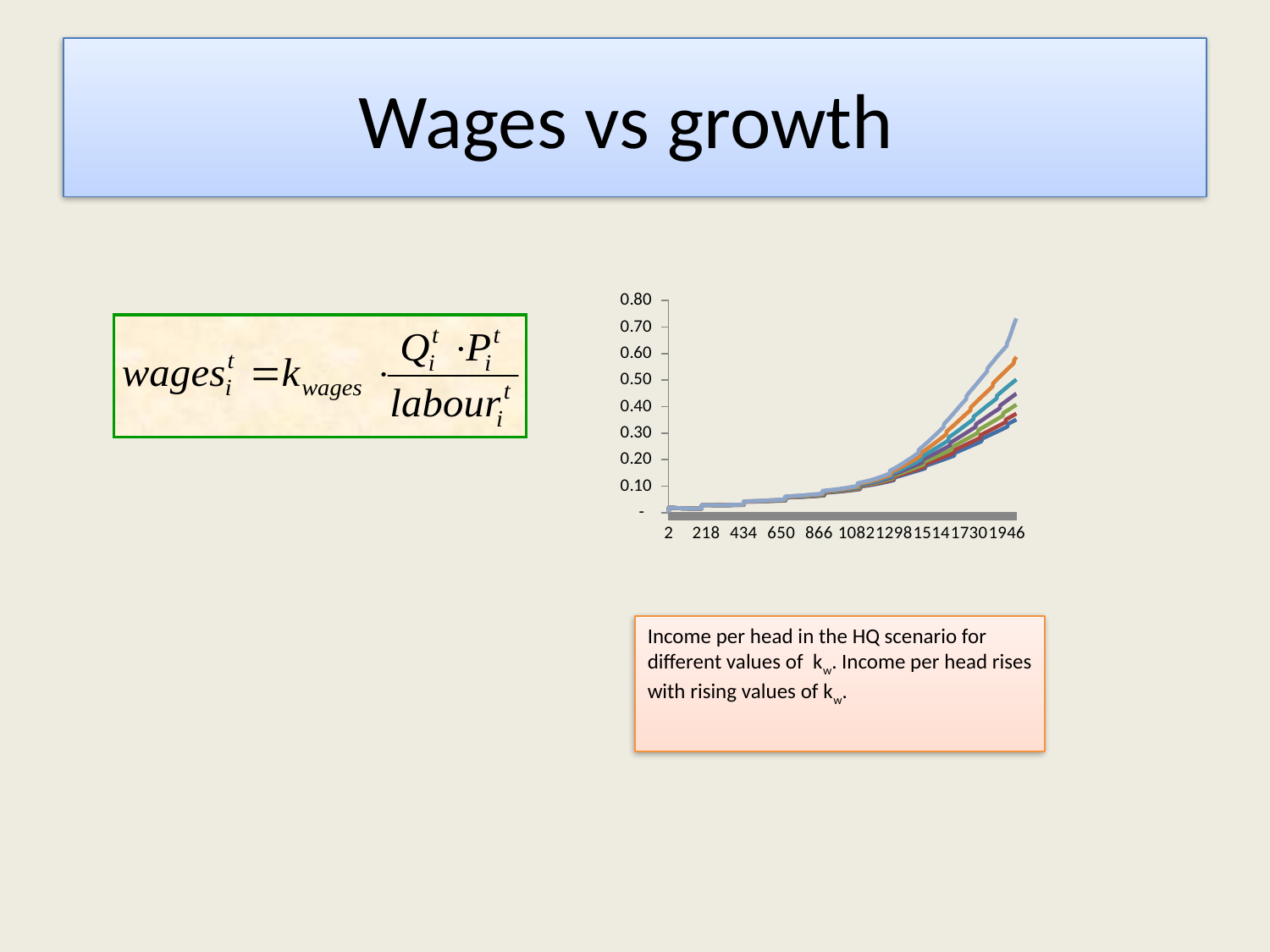
What kind of chart is shown on the slide? line chart Are the lines in the chart closer together at the left end or at the right end of the x axis? left end At the right end of the chart, is the value of the topmost line greater or less than 0.60? greater What is the highest value shown on the chart's y axis? 0.80 How many tick labels are shown on the chart's x axis? 10 What is the last label shown on the chart's x axis? 1946 At the x-axis label 650, are the lines' values greater or less than 0.20? less At the right end of the chart, is the value of the lowest line greater or less than 0.40? less Do the lines in the chart rise or fall as the x axis increases? rise